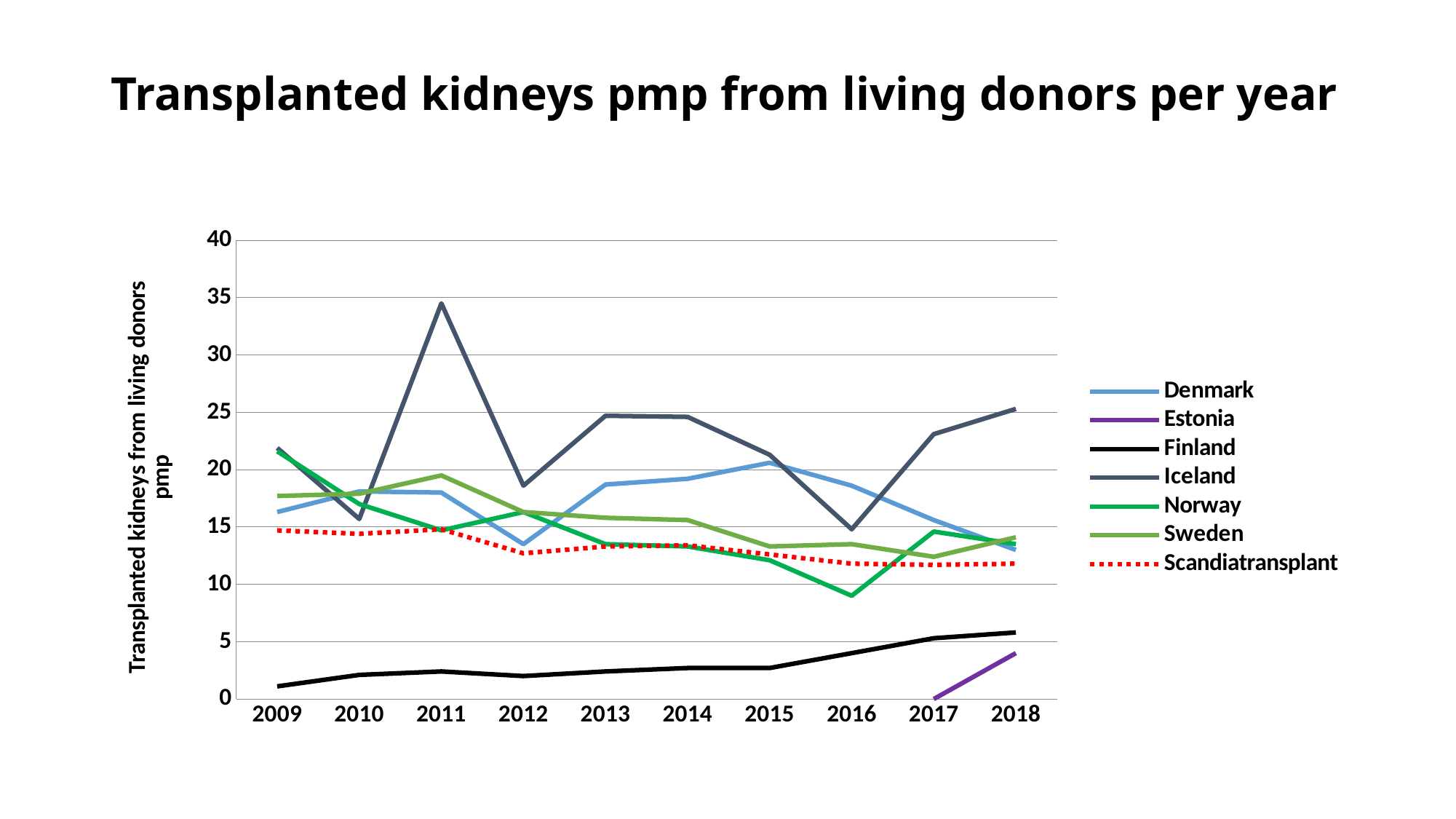
What is the title of the chart? Transplanted kidneys pmp from living donors per year Does the value for Finland generally rise or fall from 2009 to 2018? rise Which series has the highest value in 2011? Iceland Which series is drawn with a dotted red line? Scandiatransplant How many series does the legend list? 7 Is the value for Norway in 2016 greater or less than 10? less What kind of chart is shown on the slide? line chart Is the value for Finland in 2018 greater or less than 5? greater How many years are shown along the x axis? 10 Is the value for Iceland in 2011 greater or less than 30? greater Which is larger in 2015, the value for Denmark or the value for Norway? Denmark Which series has the lowest value in 2009? Finland